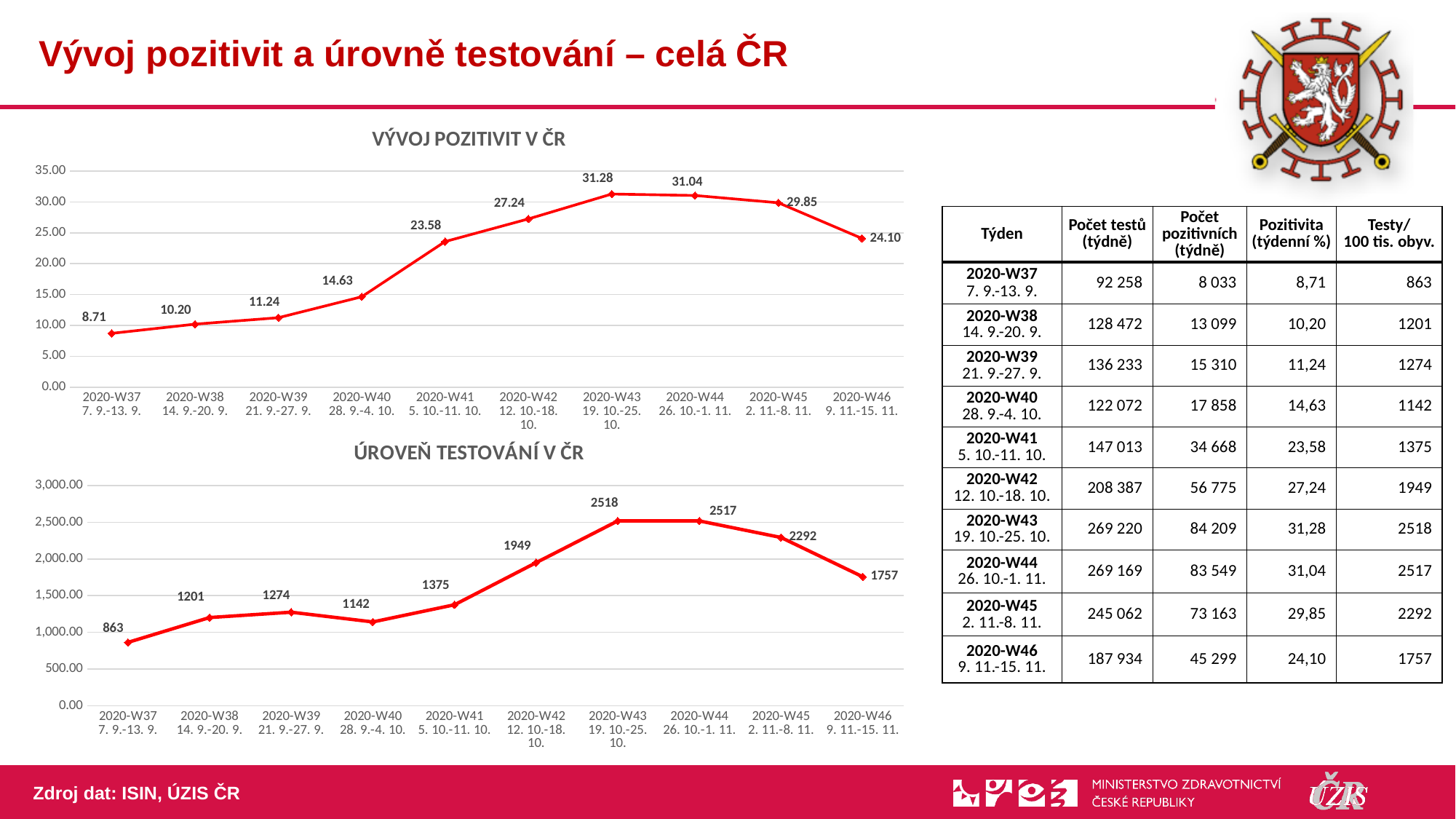
In the chart titled 'ÚROVEŇ TESTOVÁNÍ V ČR', what is the difference between the values for 2020-W45 and 2020-W46? 535 In the chart titled 'VÝVOJ POZITIVIT V ČR', what is the difference between the values for 2020-W42 and 2020-W41? 3.66 In the chart titled 'VÝVOJ POZITIVIT V ČR', how many weeks are plotted on the x axis? 10 In the chart titled 'VÝVOJ POZITIVIT V ČR', is the value for 2020-W45 greater or less than 25.00? greater In the chart titled 'ÚROVEŇ TESTOVÁNÍ V ČR', which week has the lowest value? 2020-W37 In the chart titled 'ÚROVEŇ TESTOVÁNÍ V ČR', which is larger, the value for 2020-W39 or the value for 2020-W40? 2020-W39 In the chart titled 'VÝVOJ POZITIVIT V ČR', what is the value for 2020-W41? 23.58 In the chart titled 'ÚROVEŇ TESTOVÁNÍ V ČR', what is the value for 2020-W42? 1949 In the chart titled 'VÝVOJ POZITIVIT V ČR', what is the value for 2020-W46? 24.10 In the chart titled 'ÚROVEŇ TESTOVÁNÍ V ČR', do the values rise or fall from 2020-W44 to 2020-W46? fall In the chart titled 'VÝVOJ POZITIVIT V ČR', which week has the lowest value? 2020-W37 What kind of chart is 'VÝVOJ POZITIVIT V ČR'? line chart